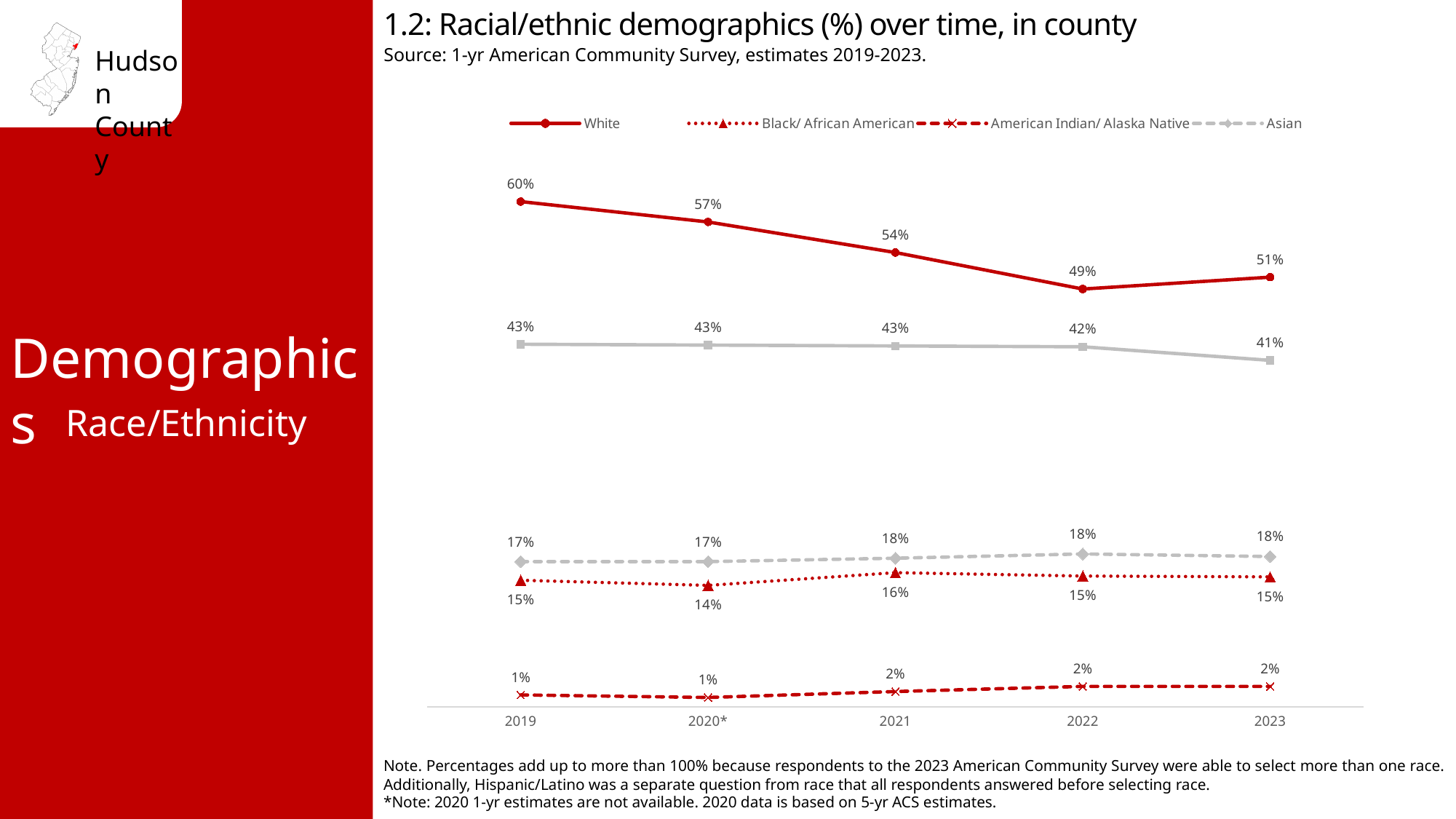
By how many percentage points did the White share change from 2019 to 2023? 9 percentage points What is the overall trend of the White line from 2019 to 2022? falling What type of chart is shown on the slide? line chart What was the American Indian/ Alaska Native percentage in 2021? 2% What was the White percentage in 2019? 60% What was the Black/ African American percentage in 2020*? 14% What was the Asian percentage in 2023? 18% What was the White percentage in 2022? 49% How many years are shown on the x axis? 5 In which year was the White percentage lowest? 2022 In which year was the White percentage highest? 2019 Which was larger in 2021, the Asian percentage or the Black/ African American percentage? Asian